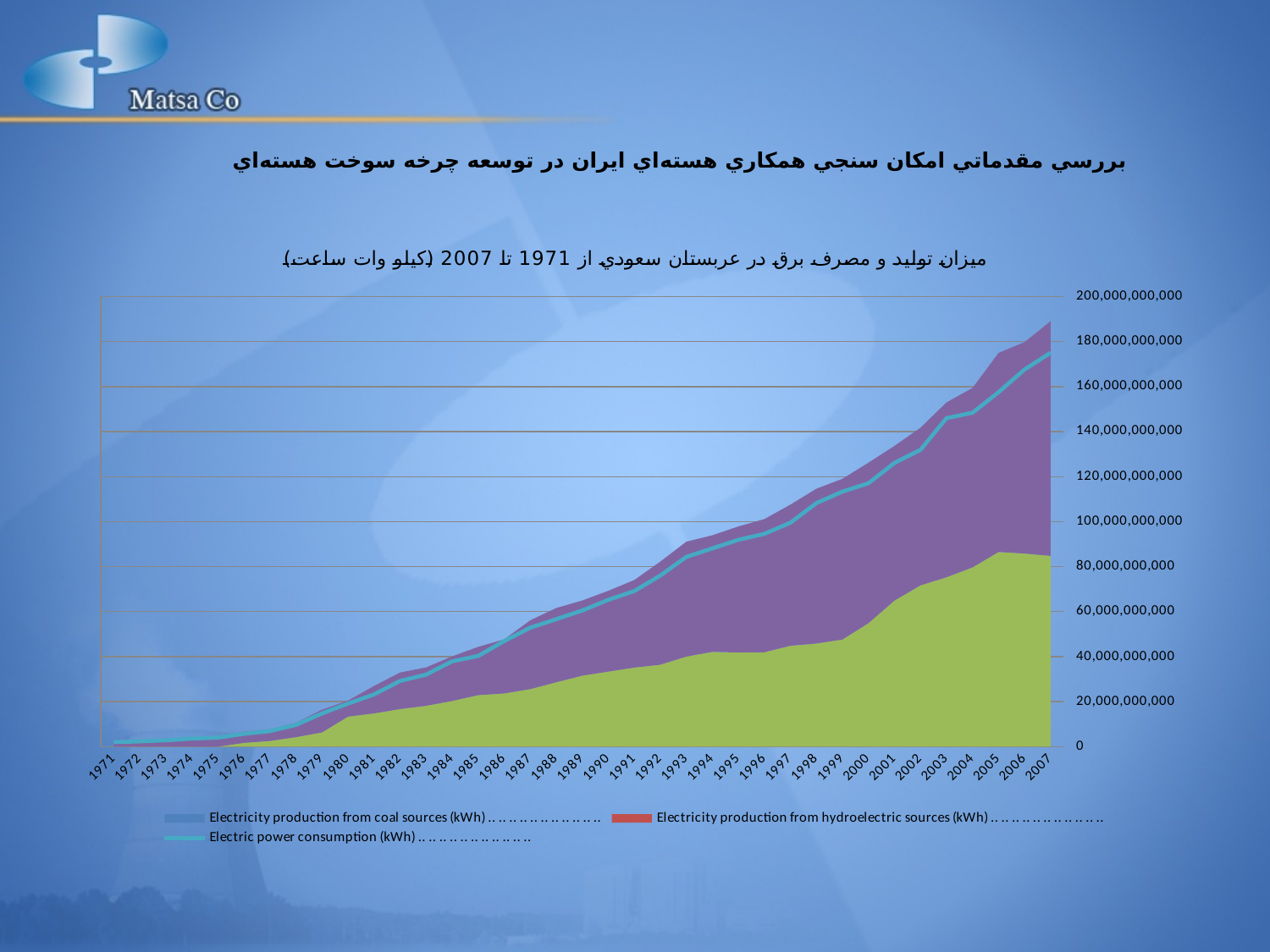
Do the plotted values generally rise or fall from 1971 to 2007? Rise What is the first year shown on the x axis of the chart? 1971 Is the value of the Electric power consumption (kWh) line in 1980 greater or less than 40,000,000,000? less What kind of chart is shown on the slide? Combination area and line chart How many series does the chart's legend list? 3 What is the last year shown on the x axis of the chart? 2007 Is the top of the stacked area in 2007 greater or less than 180,000,000,000? greater How many years are plotted along the x axis of the chart? 37 In which year does the stacked area reach its highest total? 2007 Is the value of the Electric power consumption (kWh) line in 2007 greater or less than 160,000,000,000? greater